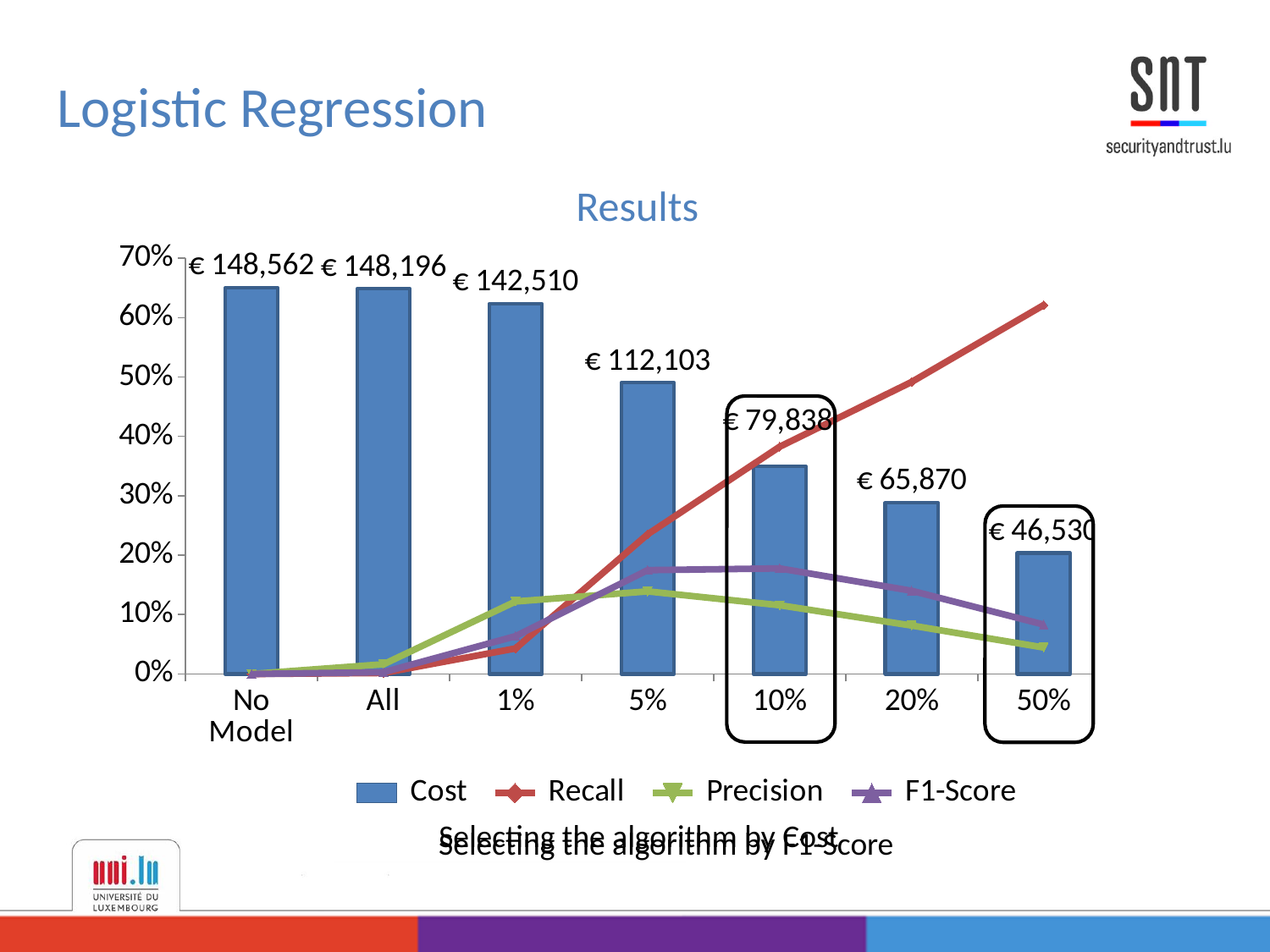
What is the difference in Cost between the 5% and 10% categories? € 32,265 How many categories are shown on the x axis? 7 How many series does the legend list? 4 What is the Cost value for the 10% category? € 79,838 Which has a higher Cost, the 20% category or the 50% category? 20% Which category has the lowest Cost? 50% Which category has the highest Cost? No Model Is the Precision value for the 50% category greater or less than 10%? less What is the Cost value for the 50% category? € 46,530 Does the Cost rise or fall moving from No Model to 50% along the x axis? fall Is the Recall value for the 50% category greater or less than 50%? greater What is the Cost value for the No Model category? € 148,562